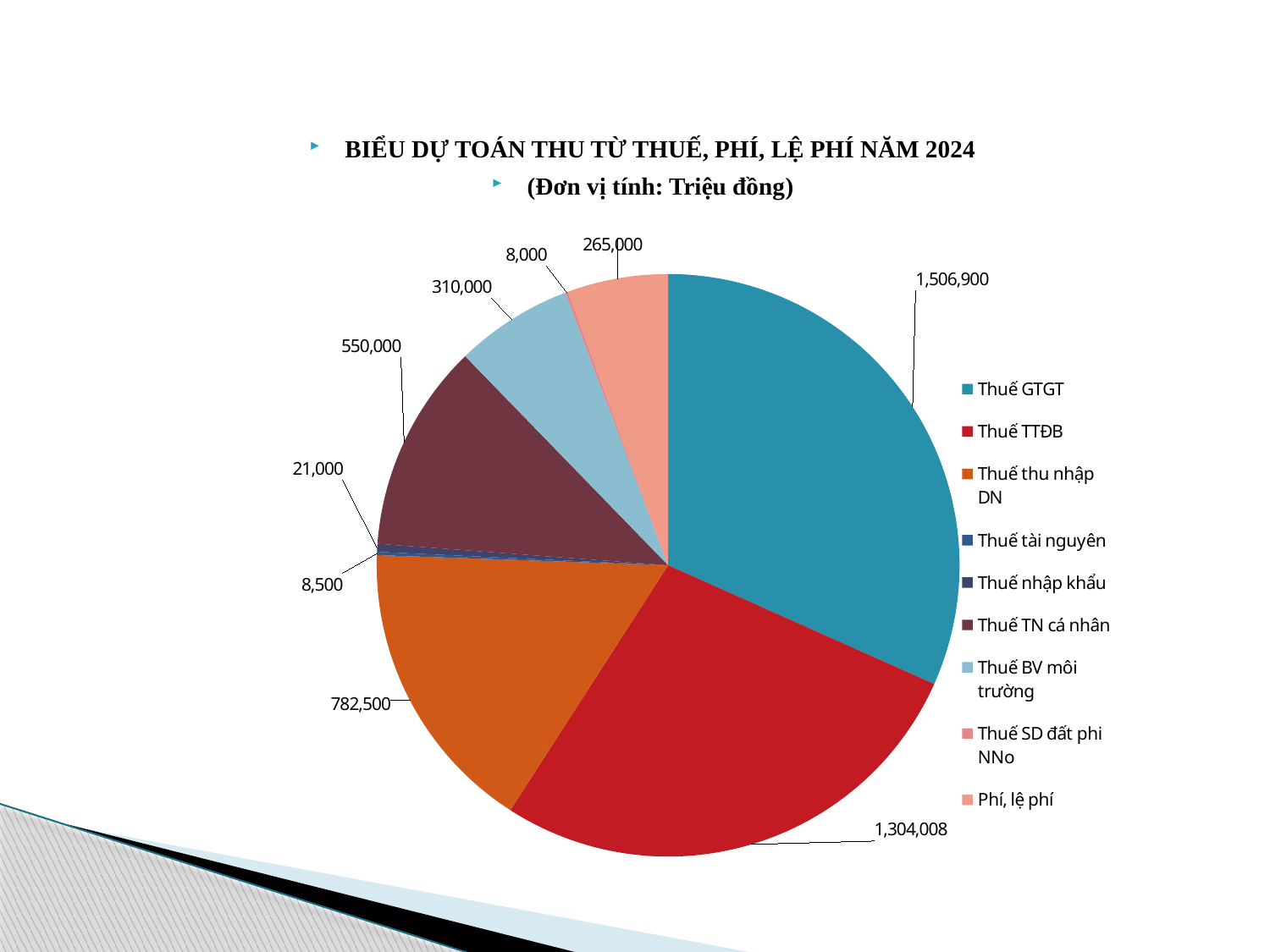
What is the difference between the values for Thuế GTGT and Thuế TTĐB? 202,892 What is the value for Thuế GTGT? 1,506,900 What is the value for Thuế TTĐB? 1,304,008 What unit of measurement is stated under the chart title? Triệu đồng How many categories does the legend list? 9 What is the value for Thuế BV môi trường? 310,000 Which category has the smallest value? Thuế SD đất phi NNo What type of chart is shown on the slide? Pie chart What is the value for Thuế thu nhập DN? 782,500 Which category has the largest slice of the pie? Thuế GTGT Which is larger, Thuế thu nhập DN or Thuế TN cá nhân? Thuế thu nhập DN What is the value for Phí, lệ phí? 265,000